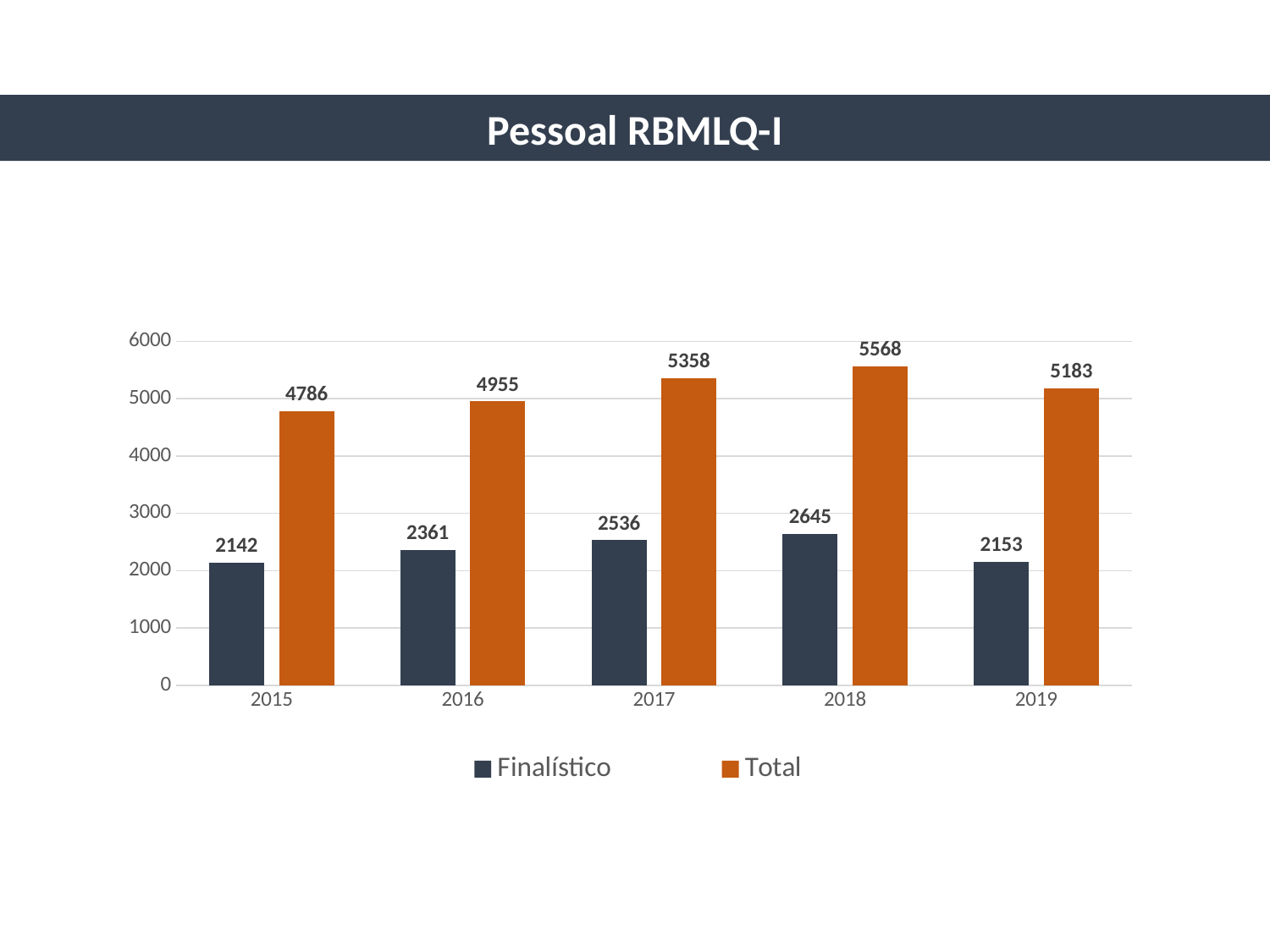
Does the Finalístico value rise or fall from 2015 to 2018? rise What is the difference between the Total and Finalístico values in 2019? 3030 How many series does the legend list? 2 How many years are shown on the x axis? 5 Which is larger: the Finalístico value for 2018 or the Finalístico value for 2019? 2018 What is the Finalístico value for 2016? 2361 What is the Total value for 2017? 5358 Which year has the lowest Finalístico value? 2015 What kind of chart is shown on the slide? bar chart Is the Total value for 2015 greater or less than 5000? less Which year has the highest Total value? 2018 What is the title of the slide? Pessoal RBMLQ-I